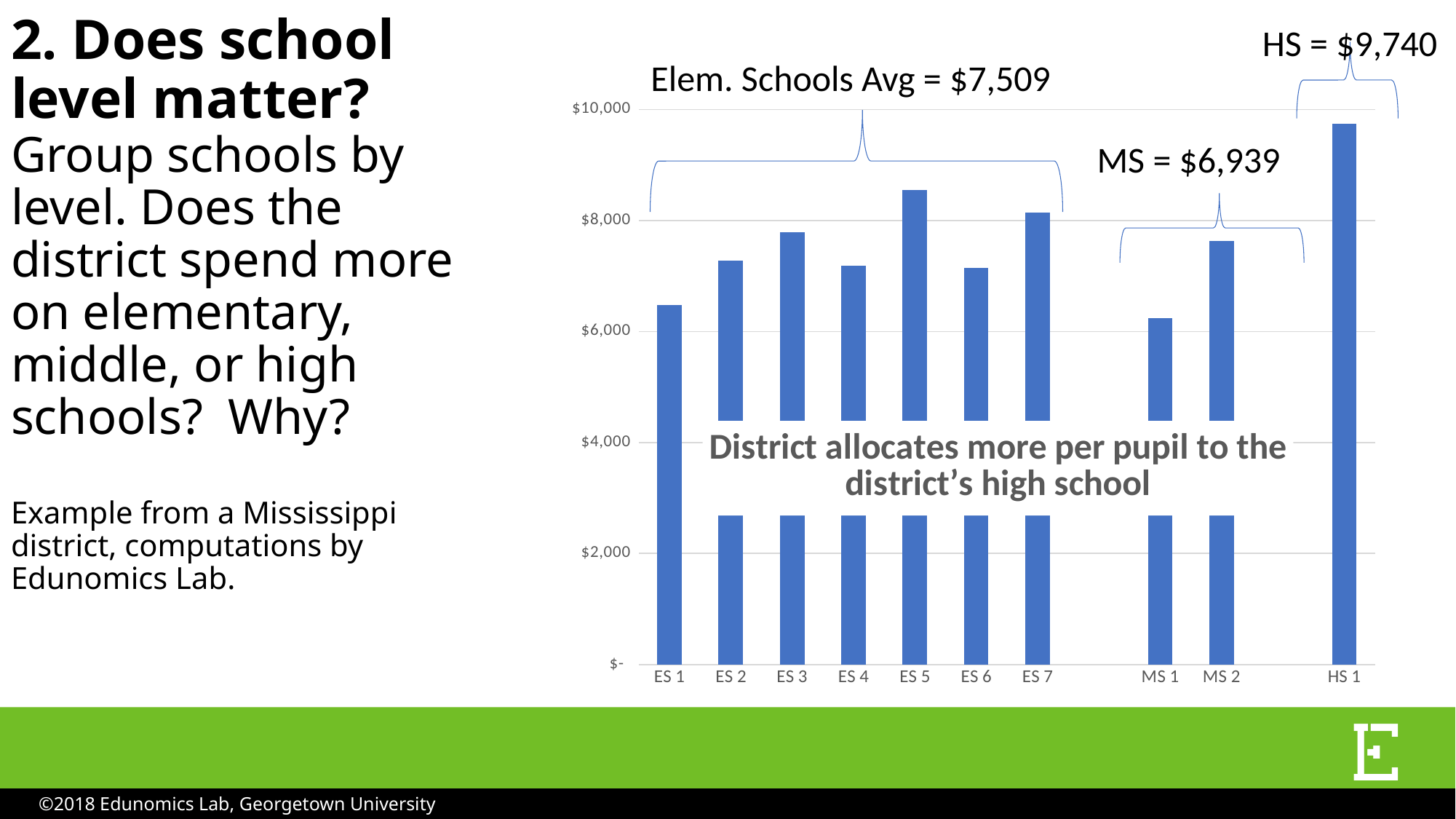
According to the annotation, what is the high school (HS) per-pupil spending figure? $9,740 Is the value for ES 5 greater or less than $8,000? greater According to the annotation, what is the middle school (MS) per-pupil spending figure? $6,939 What conclusion is written in the text overlaid on the chart? District allocates more per pupil to the district's high school What kind of chart is shown on the slide? bar chart What is the difference between the HS figure ($9,740) and the MS figure ($6,939) shown in the annotations? $2,801 According to the annotation, what is the elementary schools average per-pupil spending? $7,509 Is the value for MS 1 greater or less than $8,000? less Which has a higher value, ES 5 or ES 2? ES 5 Which school has the highest per-pupil spending in the chart? HS 1 How many schools (bars) are plotted in the chart? 10 Is the value for ES 4 greater or less than $8,000? less